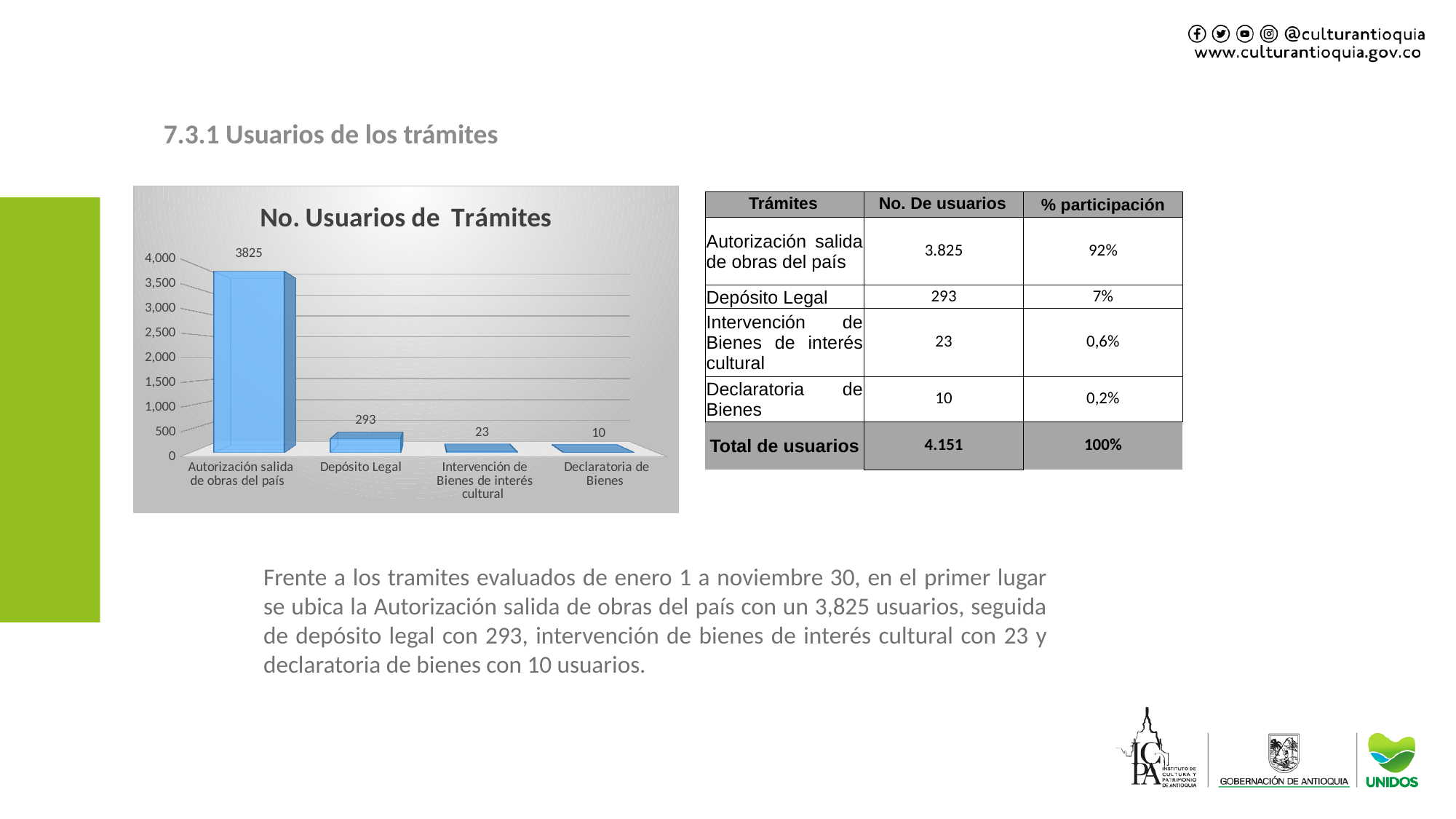
What is the title of the chart? No. Usuarios de Trámites How many categories are shown in the chart? 4 What kind of chart is shown on the slide? Bar chart What is the value for Depósito Legal in the chart? 293 Which category has the highest value in the chart? Autorización salida de obras del país Which category has the lowest value in the chart? Declaratoria de Bienes What is the value for Intervención de Bienes de interés cultural in the chart? 23 Do the values rise or fall from left to right along the x axis? Fall What is the value for Declaratoria de Bienes in the chart? 10 What is the difference between the values for Autorización salida de obras del país and Depósito Legal? 3532 What is the value for Autorización salida de obras del país in the chart? 3825 Which is larger, the value for Depósito Legal or the value for Intervención de Bienes de interés cultural? Depósito Legal